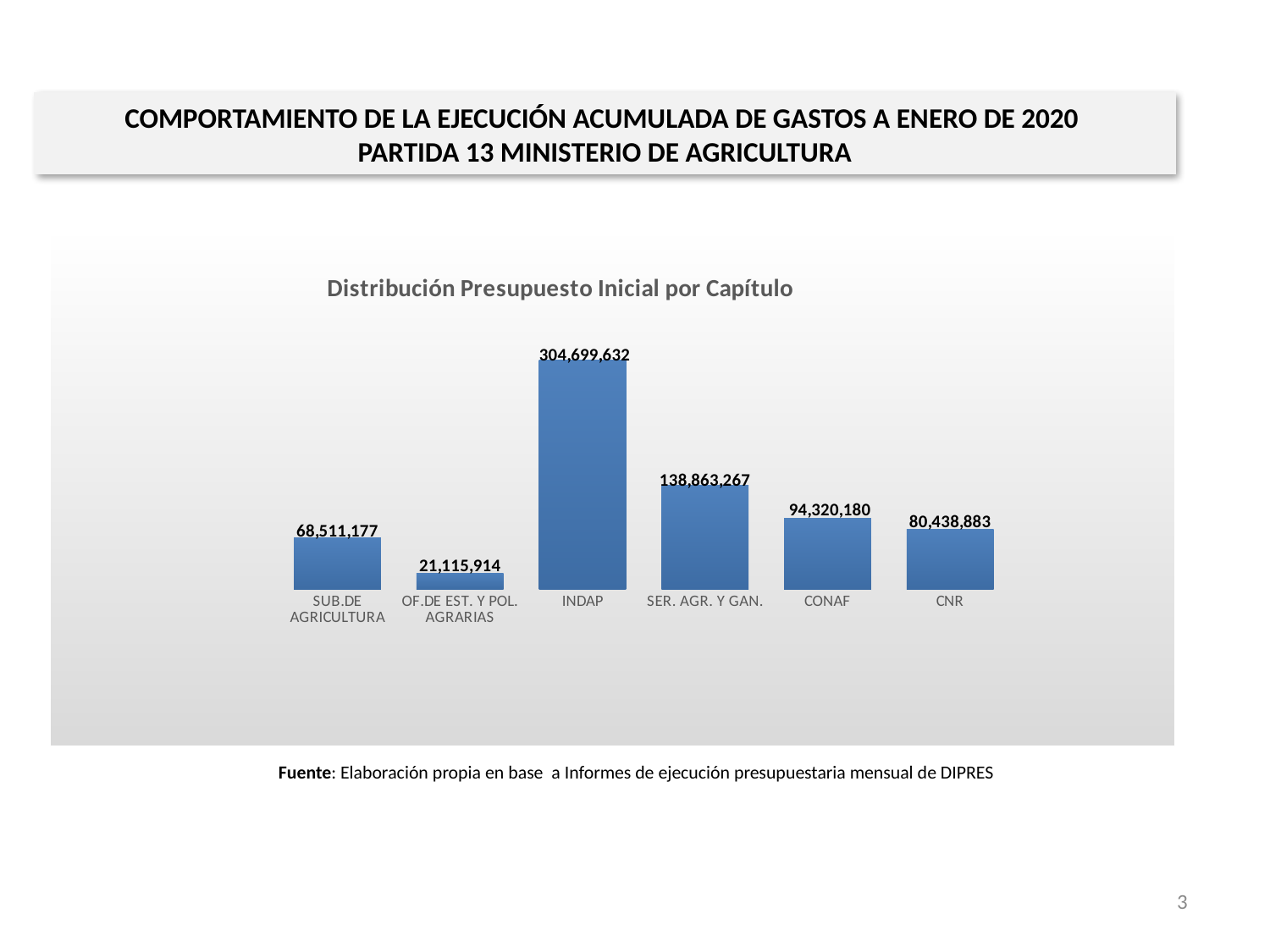
Which category has the lowest value in the chart? OF.DE EST. Y POL. AGRARIAS What is the difference between the values for CONAF and CNR? 13,881,297 What is the value for CONAF in the chart? 94,320,180 What is the value for OF.DE EST. Y POL. AGRARIAS in the chart? 21,115,914 What is the value for INDAP in the chart? 304,699,632 What is the value for SER. AGR. Y GAN. in the chart? 138,863,267 Which is larger, the value for SUB.DE AGRICULTURA or the value for CNR? CNR How many categories are shown in the chart? 6 What is the title of the chart? Distribución Presupuesto Inicial por Capítulo Which category has the highest value in the chart? INDAP What kind of chart is shown on the slide? Bar chart What is the difference between the values for INDAP and SER. AGR. Y GAN.? 165,836,365